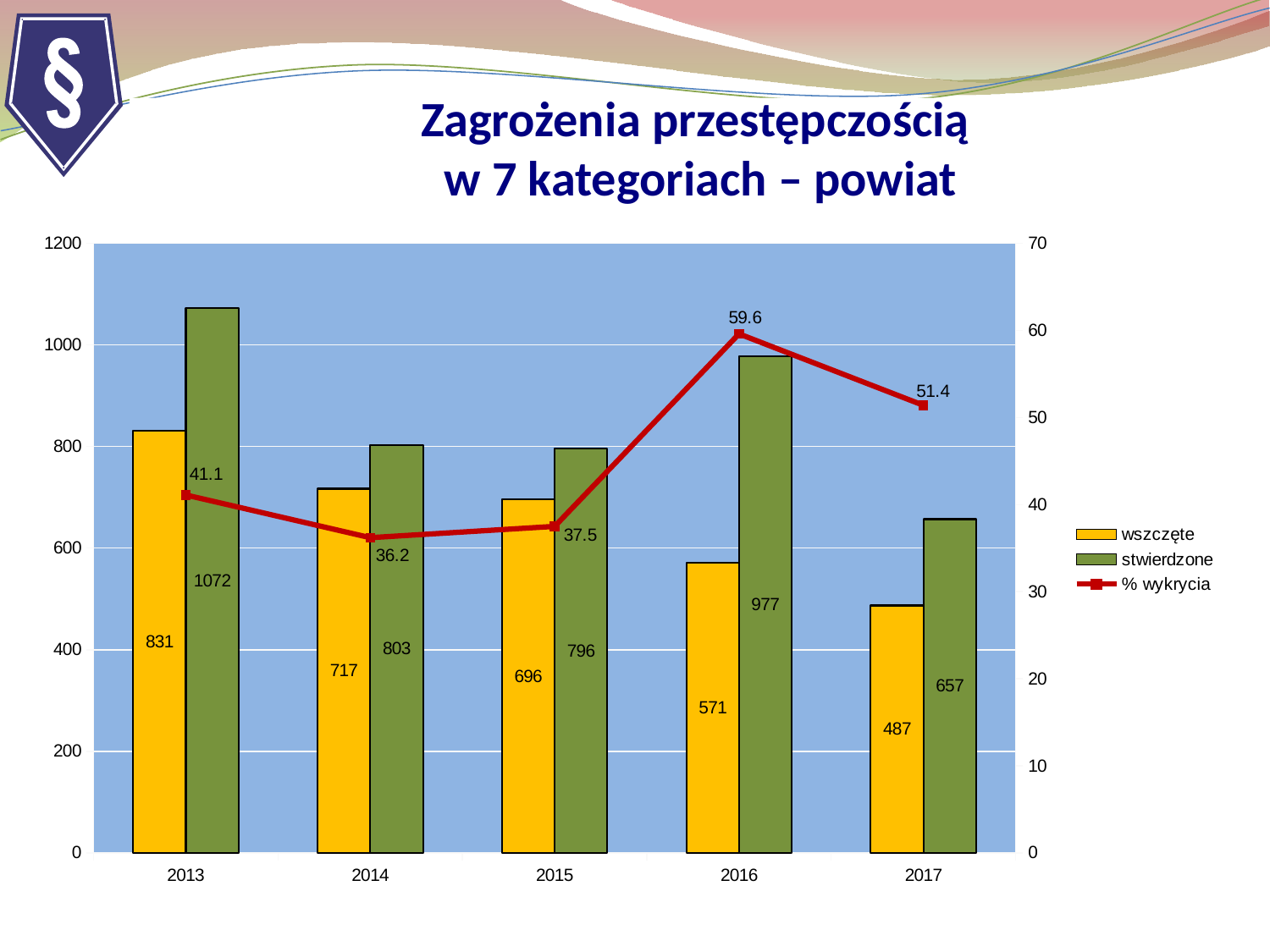
Which is larger in 2015: 'wszczęte' or 'stwierdzone'? stwierdzone Which year has the highest '% wykrycia' value? 2016 What is the '% wykrycia' value for 2017? 51.4 What is the value of 'stwierdzone' for 2016? 977 How many series does the legend list? 3 How many years are shown on the x axis? 5 Which year has the lowest 'wszczęte' value? 2017 Which year has the highest 'stwierdzone' value? 2013 What is the difference between 'stwierdzone' and 'wszczęte' in 2014? 86 Does the 'wszczęte' series rise or fall from 2013 to 2017? fall What is the value of 'wszczęte' for 2013? 831 What colour is the '% wykrycia' line? red